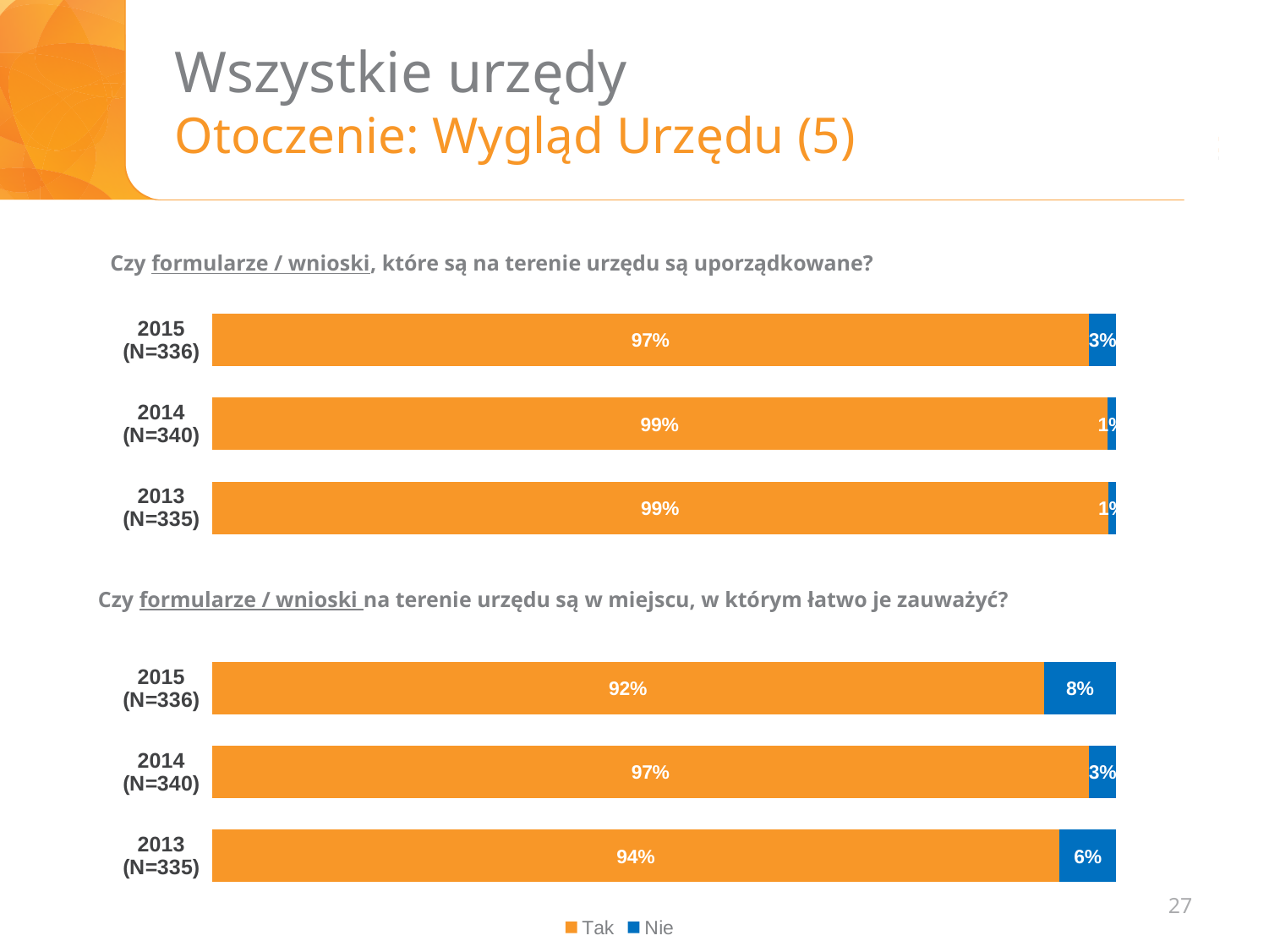
What type of chart is used for the bottom chart ("Czy formularze / wnioski na terenie urzędu są w miejscu, w którym łatwo je zauważyć?")? Stacked bar chart In the top chart ("Czy formularze / wnioski, które są na terenie urzędu są uporządkowane?"), what percentage answered Nie in 2015 (N=336)? 3% In the bottom chart ("Czy formularze / wnioski na terenie urzędu są w miejscu, w którym łatwo je zauważyć?"), what percentage answered Nie in 2013 (N=335)? 6% In the bottom chart ("Czy formularze / wnioski na terenie urzędu są w miejscu, w którym łatwo je zauważyć?"), what is the difference in percentage points between the Tak share in 2014 (N=340) and in 2015 (N=336)? 5 percentage points How many year categories does the top chart ("Czy formularze / wnioski, które są na terenie urzędu są uporządkowane?") show? 3 How many series does the legend at the bottom of the slide list? 2 In the bottom chart ("Czy formularze / wnioski na terenie urzędu są w miejscu, w którym łatwo je zauważyć?"), which year has the highest Nie share? 2015 (N=336) In the bottom chart ("Czy formularze / wnioski na terenie urzędu są w miejscu, w którym łatwo je zauważyć?"), what percentage answered Tak in 2015 (N=336)? 92% In the bottom chart ("Czy formularze / wnioski na terenie urzędu są w miejscu, w którym łatwo je zauważyć?"), which year has the lowest Tak share? 2015 (N=336) In the top chart ("Czy formularze / wnioski, które są na terenie urzędu są uporządkowane?"), what percentage answered Tak in 2014 (N=340)? 99% In the top chart ("Czy formularze / wnioski, które są na terenie urzędu są uporządkowane?"), what percentage answered Tak in 2015 (N=336)? 97% In the bottom chart ("Czy formularze / wnioski na terenie urzędu są w miejscu, w którym łatwo je zauważyć?"), is the Nie share larger in 2013 (N=335) or in 2014 (N=340)? 2013 (N=335)